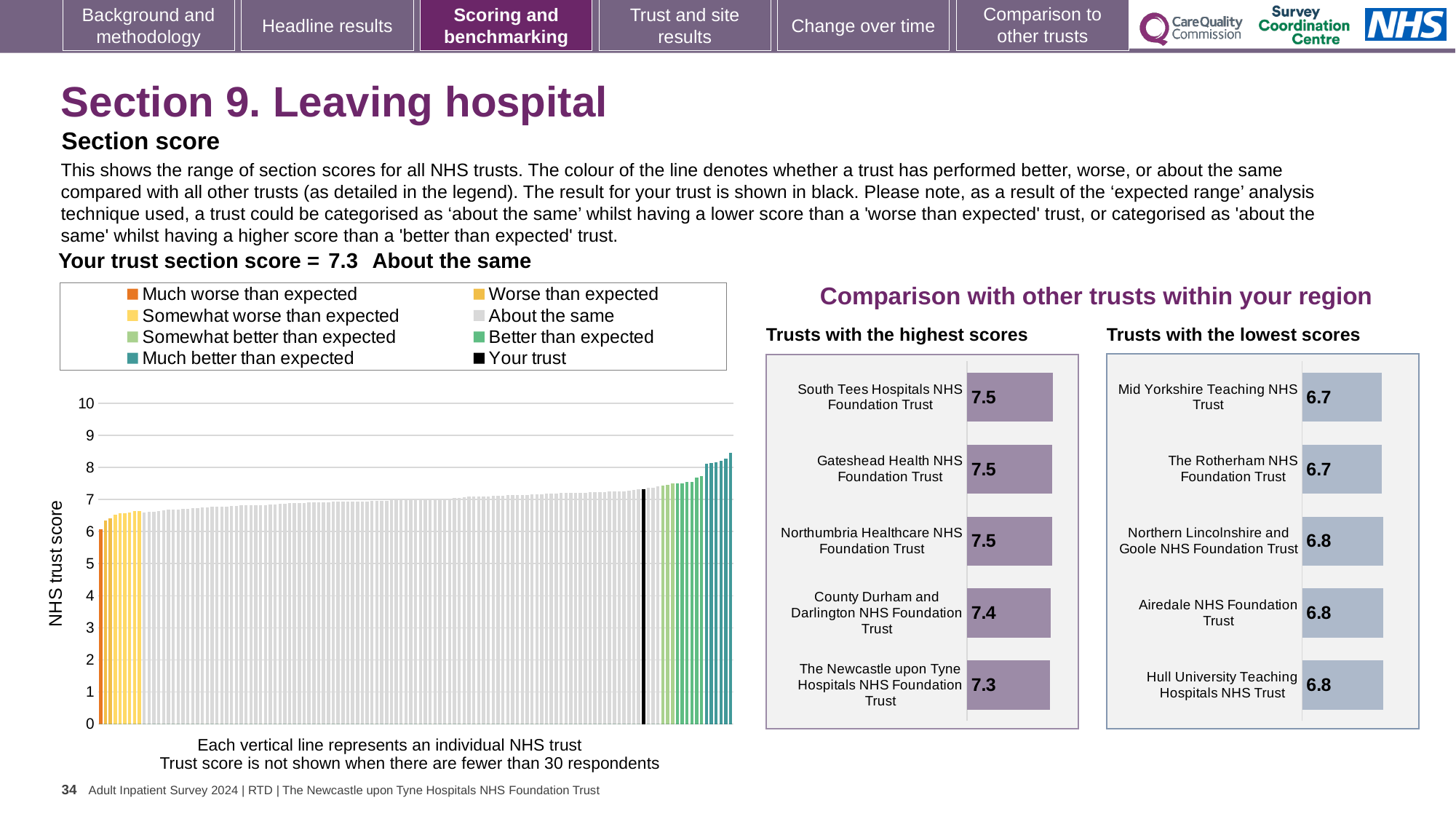
In the 'Trusts with the highest scores' chart, which trust has the lowest score? The Newcastle upon Tyne Hospitals NHS Foundation Trust What kind of chart is the large chart on the left showing NHS trust scores? Bar chart In the 'Trusts with the highest scores' chart, how many trusts are listed? 5 In the 'Trusts with the highest scores' chart, what is the score for South Tees Hospitals NHS Foundation Trust? 7.5 In the large chart on the left, do the trust scores rise or fall from left to right along the x axis? Rise In the 'Trusts with the lowest scores' chart, what is the difference between the scores of Hull University Teaching Hospitals NHS Trust and Mid Yorkshire Teaching NHS Trust? 0.1 In the 'Trusts with the highest scores' chart, what is the difference between the scores of South Tees Hospitals NHS Foundation Trust and The Newcastle upon Tyne Hospitals NHS Foundation Trust? 0.2 In the 'Trusts with the lowest scores' chart, what is the score for Mid Yorkshire Teaching NHS Trust? 6.7 In the 'Trusts with the lowest scores' chart, what is the score for Airedale NHS Foundation Trust? 6.8 In the 'Trusts with the highest scores' chart, what is the score for County Durham and Darlington NHS Foundation Trust? 7.4 How many entries does the legend of the large chart on the left list? 8 In the 'Trusts with the lowest scores' chart, which is larger: the score for Hull University Teaching Hospitals NHS Trust or The Rotherham NHS Foundation Trust? Hull University Teaching Hospitals NHS Trust